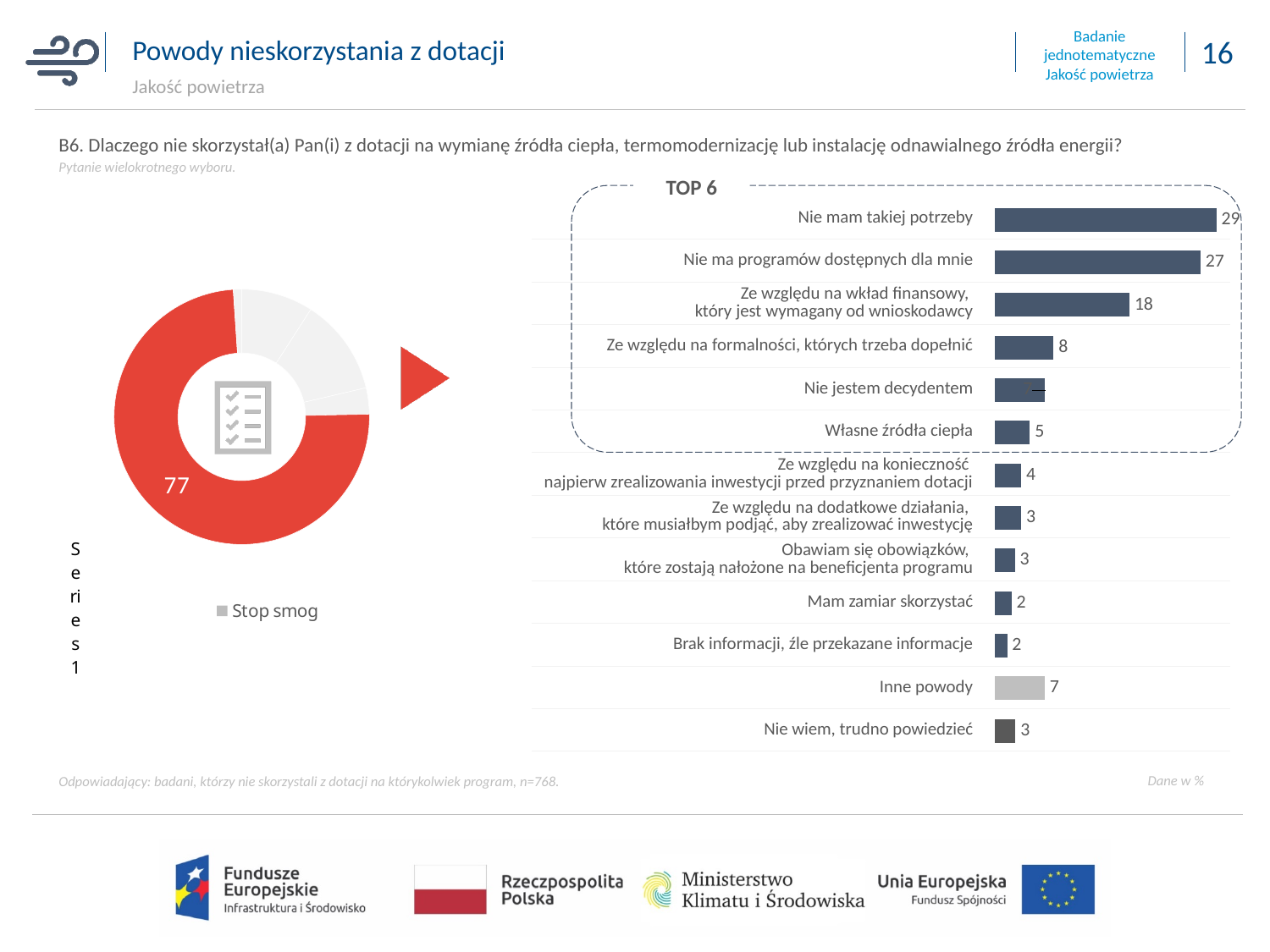
What kind of chart is shown on the right side of the slide? Bar chart In the bar chart on the right, what is the value for "Nie mam takiej potrzeby"? 29 What label is shown above the dashed box in the bar chart on the right? TOP 6 In the bar chart on the right, what is the value for "Nie ma programów dostępnych dla mnie"? 27 In the bar chart on the right, what is the difference between the values for "Nie mam takiej potrzeby" and "Ze względu na wkład finansowy, który jest wymagany od wnioskodawcy"? 11 In the bar chart on the right, what is the value for "Ze względu na formalności, których trzeba dopełnić"? 8 In the bar chart on the right, which is larger: the value for "Własne źródła ciepła" or the value for "Inne powody"? Inne powody In the bar chart on the right, which category has the highest value? Nie mam takiej potrzeby In the bar chart on the right, what is the difference between the values for "Ze względu na wkład finansowy, który jest wymagany od wnioskodawcy" and "Ze względu na formalności, których trzeba dopełnić"? 10 In the bar chart on the right, what is the value for "Inne powody"? 7 How many categories are shown in the bar chart on the right? 13